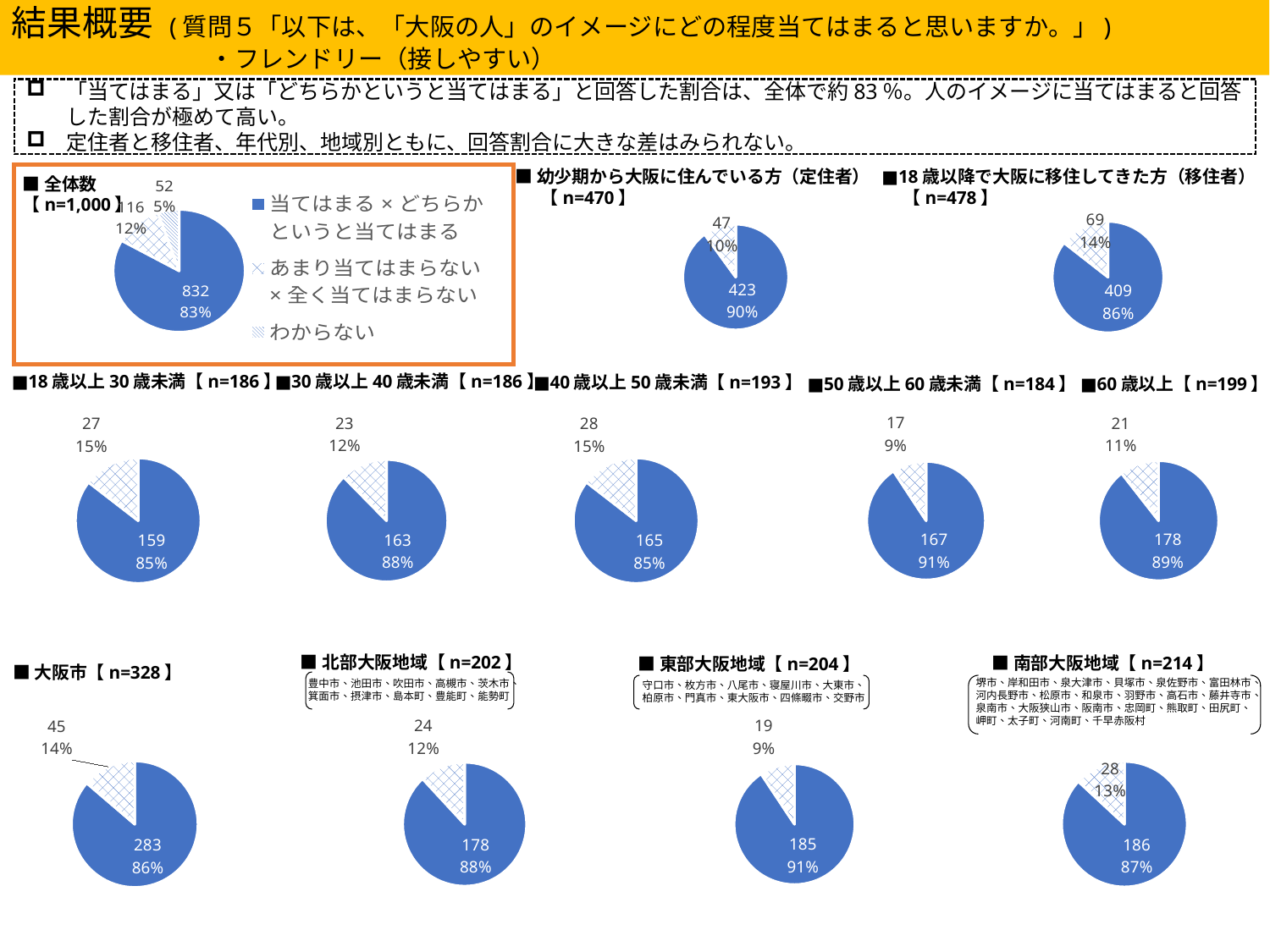
Which chart shows a larger percentage for the largest slice: 幼少期から大阪に住んでいる方（定住者） or 18歳以降で大阪に移住してきた方（移住者）? 幼少期から大阪に住んでいる方（定住者） Among the four regional charts (大阪市, 北部大阪地域, 東部大阪地域, 南部大阪地域), which has the lowest percentage for the largest slice? 大阪市【n=328】 In the 50歳以上60歳未満【n=184】 chart, what is the difference between the two slice values (167 and 17)? 150 In the 大阪市【n=328】 chart, what value is shown for the largest slice? 283 What kind of chart is used for the 全体数【n=1,000】 data? Pie chart In the 全体数【n=1,000】 chart, what percentage is shown for the わからない slice? 5% How many entries does the legend of the 全体数【n=1,000】 chart list? 3 Among the five age-group charts (18歳以上30歳未満 to 60歳以上), which has the highest percentage for the largest slice? 50歳以上60歳未満【n=184】 In the 18歳以降で大阪に移住してきた方（移住者）【n=478】 chart, what value is shown for the smaller slice? 69 In the 幼少期から大阪に住んでいる方（定住者）【n=470】 chart, what percentage is shown for the largest slice? 90% In the 全体数【n=1,000】 chart, what value is shown for the 当てはまる×どちらかというと当てはまる slice? 832 In the 東部大阪地域【n=204】 chart, what percentage is shown for the smaller slice? 9%